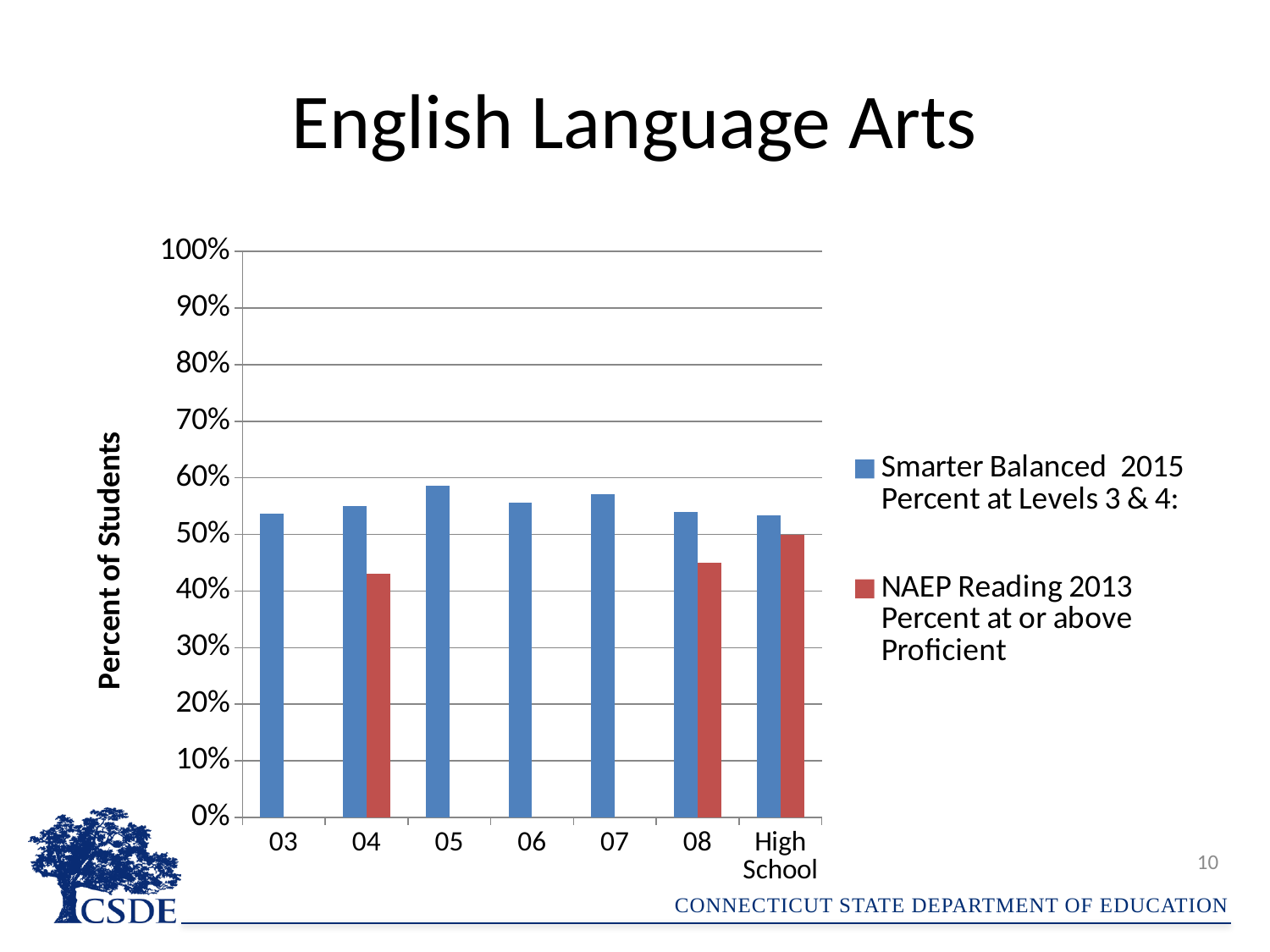
How many grade categories are shown on the x axis? 7 Which grade has the highest Smarter Balanced 2015 Percent at Levels 3 & 4? 05 For grade 08, which is larger: the Smarter Balanced 2015 value or the NAEP Reading 2013 value? Smarter Balanced 2015 Is the Smarter Balanced 2015 value for grade 05 greater or less than 50%? greater Is the NAEP Reading 2013 value for grade 04 greater or less than 50%? less For grade 04, which is larger: the Smarter Balanced 2015 value or the NAEP Reading 2013 value? Smarter Balanced 2015 What is the title of the vertical axis? Percent of Students What kind of chart is shown on the slide? bar chart How many series does the legend list? 2 For how many grade categories is a NAEP Reading 2013 bar plotted? 3 Which grade has the highest NAEP Reading 2013 Percent at or above Proficient? High School Is the Smarter Balanced 2015 value for grade 03 greater or less than 60%? less